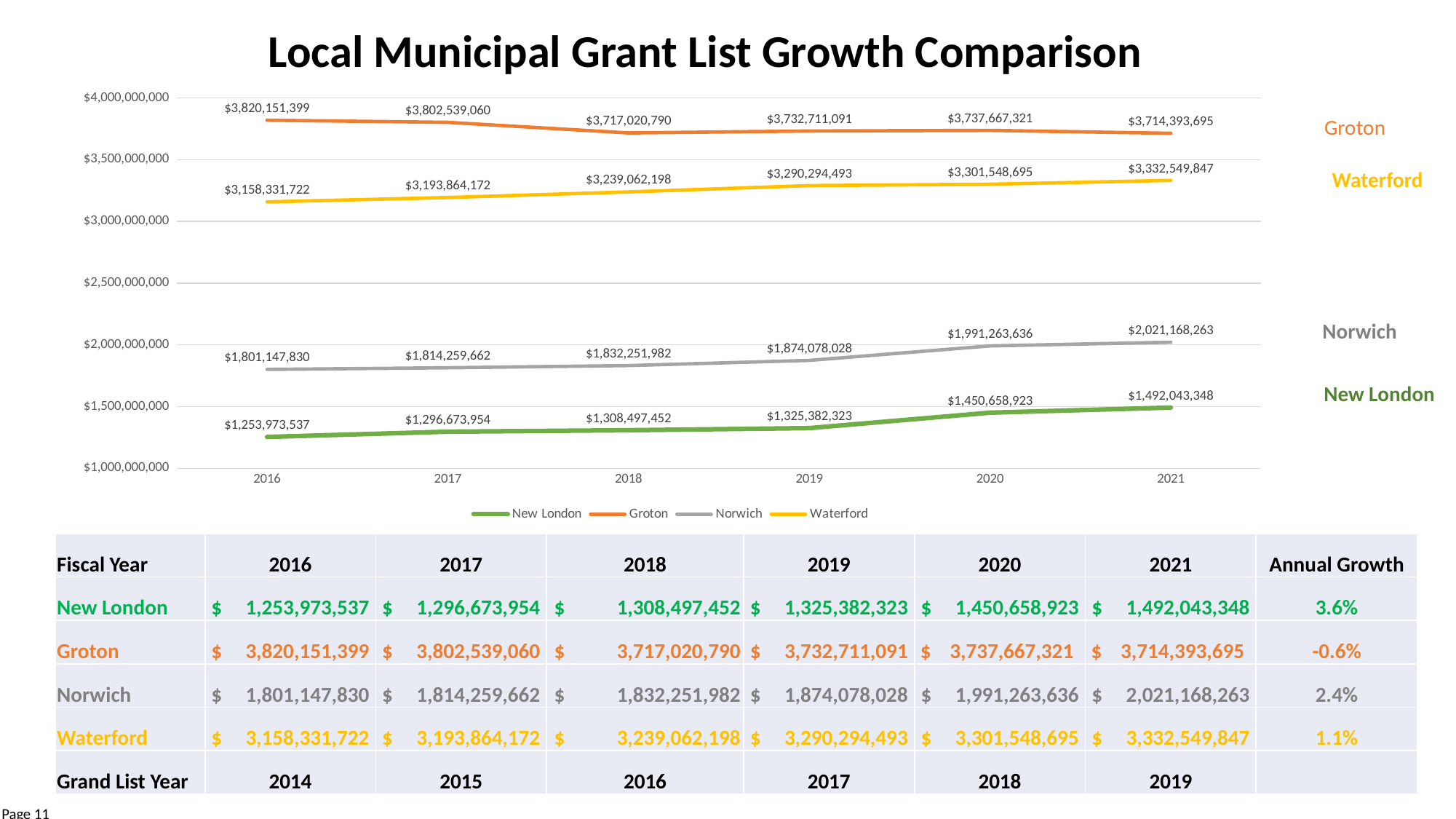
How many series does the legend list? 4 What is the difference between the Norwich values for 2021 and 2016? $220,020,433 What is the value for Waterford in 2019? $3,290,294,493 Do the New London values rise or fall from 2016 to 2021? rise In which year is the New London value lowest? 2016 What is the value for Norwich in 2020? $1,991,263,636 In which year is the Groton value highest? 2016 Which is larger, the Waterford value in 2021 or the Groton value in 2021? Groton What is the value for Groton in 2021? $3,714,393,695 What is the value for New London in 2016? $1,253,973,537 How many years are shown on the x axis? 6 Is the value for Norwich in 2021 greater or less than $2,000,000,000? greater